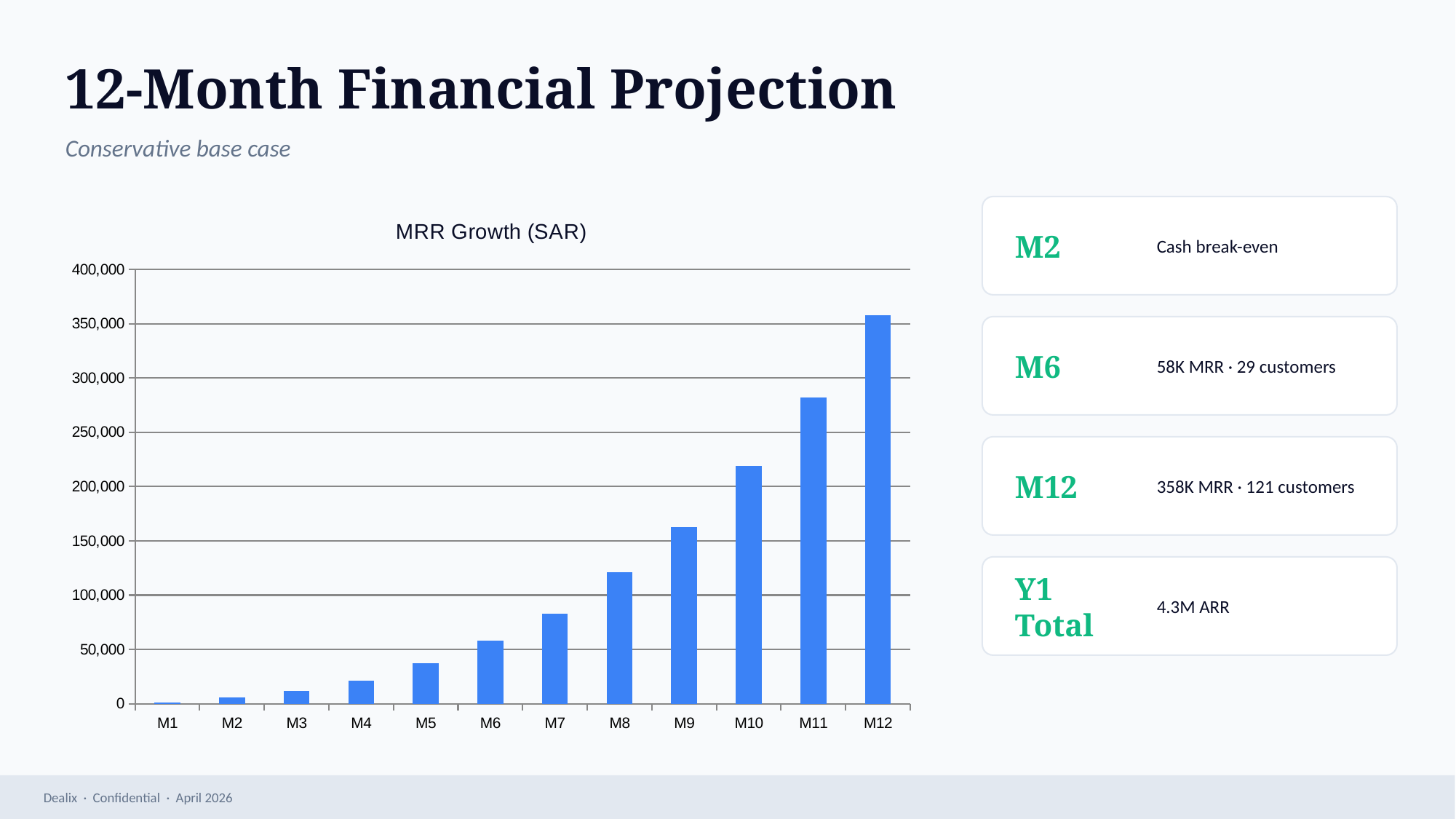
How many months (categories) are plotted on the x axis of the chart? 12 Is the value for M5 greater or less than 50,000? less Is the value for M10 greater or less than 200,000? greater Is the value for M11 greater or less than 300,000? less Which month has the highest MRR in the chart? M12 What kind of chart is shown on the slide? bar chart Do the MRR values rise or fall from M1 to M12? rise Which month has the lowest MRR in the chart? M1 Which is larger, the value for M9 or the value for M8? M9 What is the title of the chart? MRR Growth (SAR)